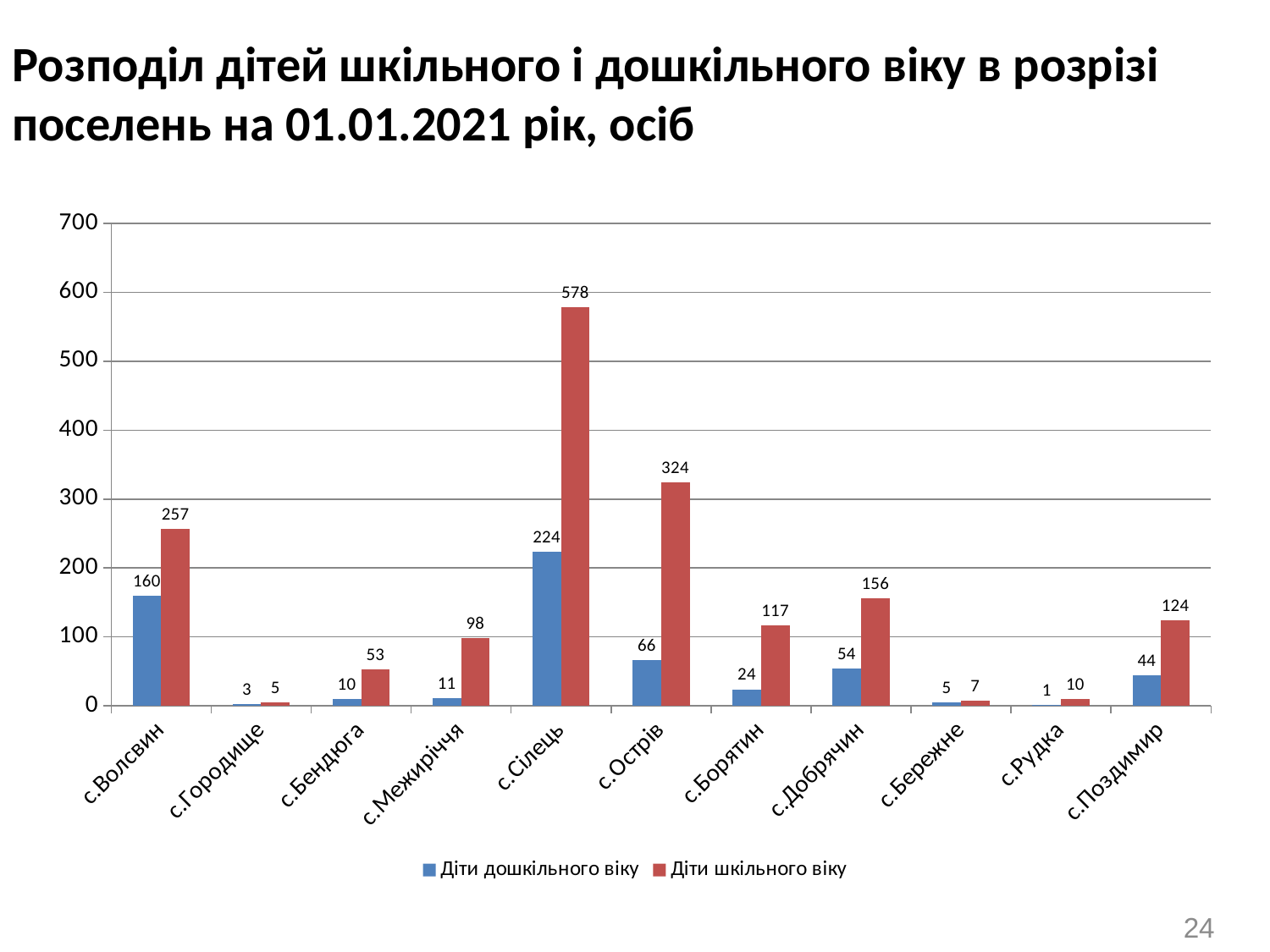
Which is larger in с.Добрячин: Діти дошкільного віку or Діти шкільного віку? Діти шкільного віку How many series does the legend list? 2 Is the value for Діти шкільного віку in с.Волсвин greater or less than 200? greater Which settlement has the highest value for Діти шкільного віку? с.Сілець What colour are the bars for Діти шкільного віку? red What is the difference between Діти шкільного віку and Діти дошкільного віку in с.Острів? 258 Which settlement has the lowest value for Діти дошкільного віку? с.Рудка How many settlements are shown on the x axis? 11 What is the value for Діти шкільного віку in с.Сілець? 578 What is the value for Діти дошкільного віку in с.Волсвин? 160 What is the value for Діти шкільного віку in с.Поздимир? 124 What kind of chart is shown on the slide? bar chart